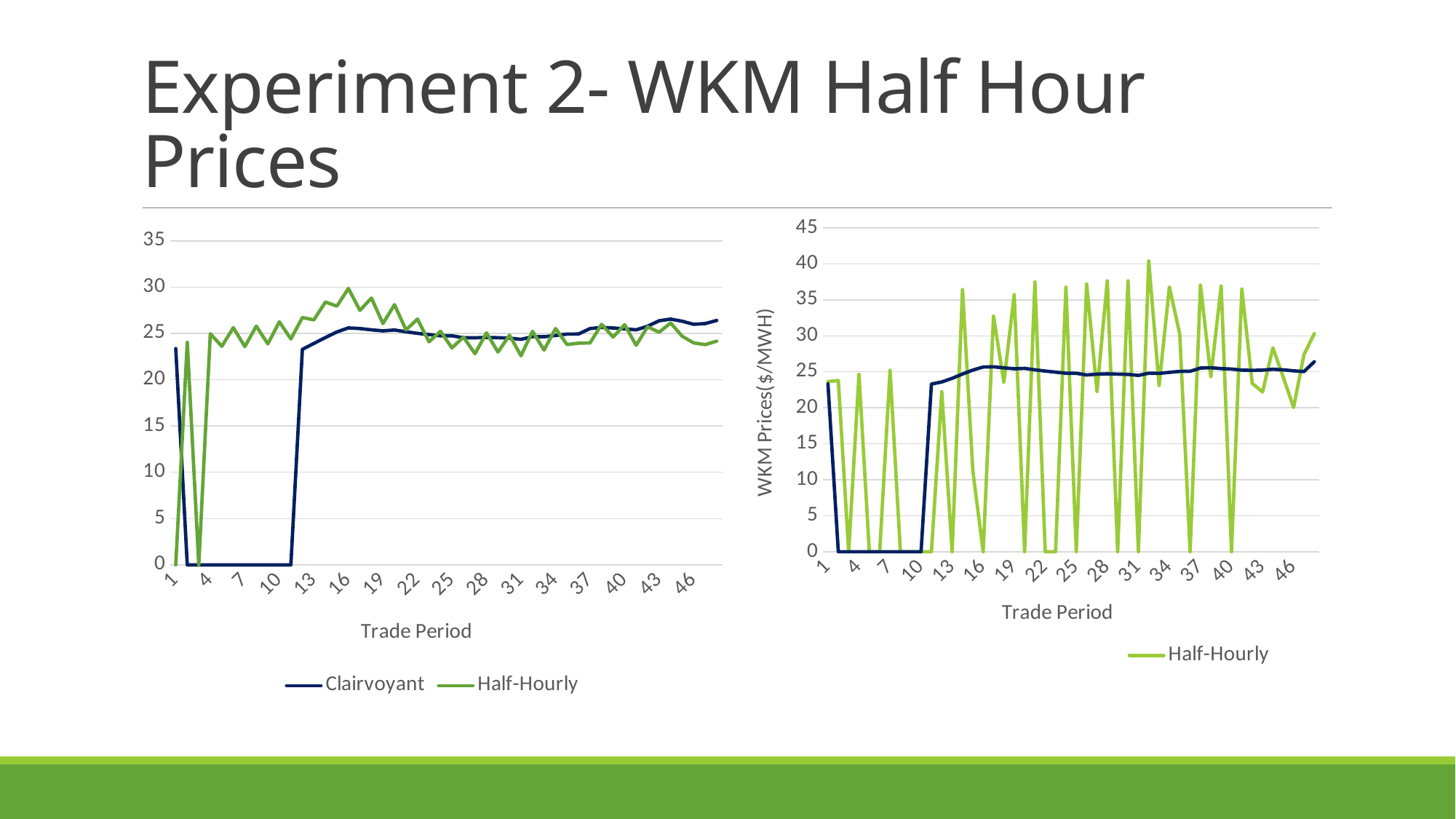
What kind of chart is the right chart on the slide? line chart In the left chart, which series is higher at trade period 17, Clairvoyant or Half-Hourly? Half-Hourly How many series does the legend of the left chart list? 2 In the left chart, is the Half-Hourly value at trade period 17 greater or less than 25? greater What is the y-axis title of the right chart? WKM Prices($/MWH) How many series does the legend of the right chart list? 1 In the left chart, is the Clairvoyant value at trade period 7 greater or less than 5? less In the left chart, what are the two series named in the legend? Clairvoyant and Half-Hourly In the right chart, is the Half-Hourly value at trade period 1 greater or less than 20? greater What kind of chart is the left chart on the slide? line chart